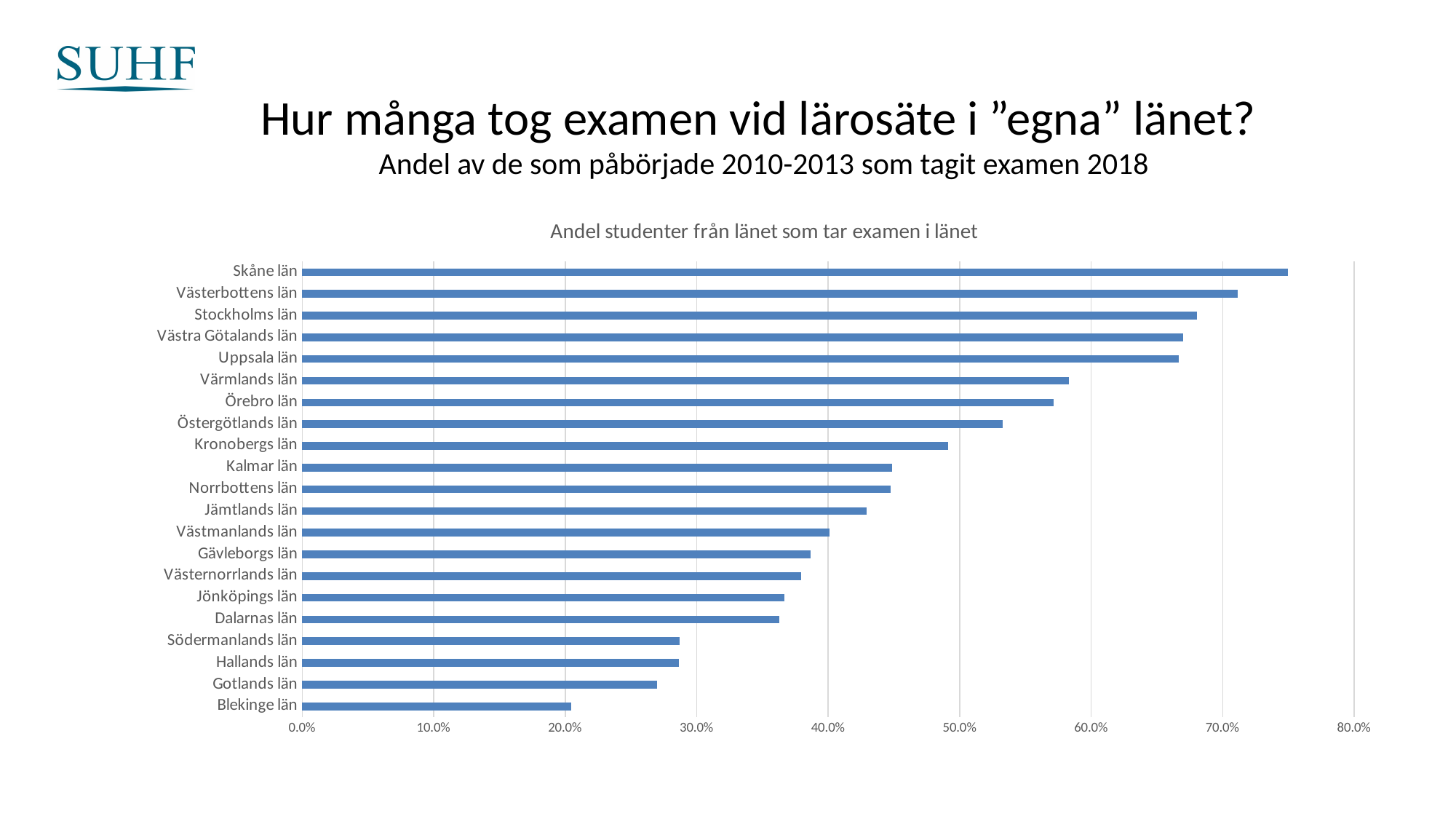
Is the value for Kronobergs län greater or less than 50%? less Is the value for Dalarnas län greater or less than 40%? less Which county has the lowest share of students taking their degree in the county? Blekinge län Is the value for Gotlands län greater or less than 30%? less Which county has the highest share of students taking their degree in the county? Skåne län What kind of chart is shown on the slide? bar chart Which has a larger value, Stockholms län or Örebro län? Stockholms län What is the title of the chart? Andel studenter från länet som tar examen i länet How many counties are shown in the chart? 21 Which has a larger value, Hallands län or Jämtlands län? Jämtlands län